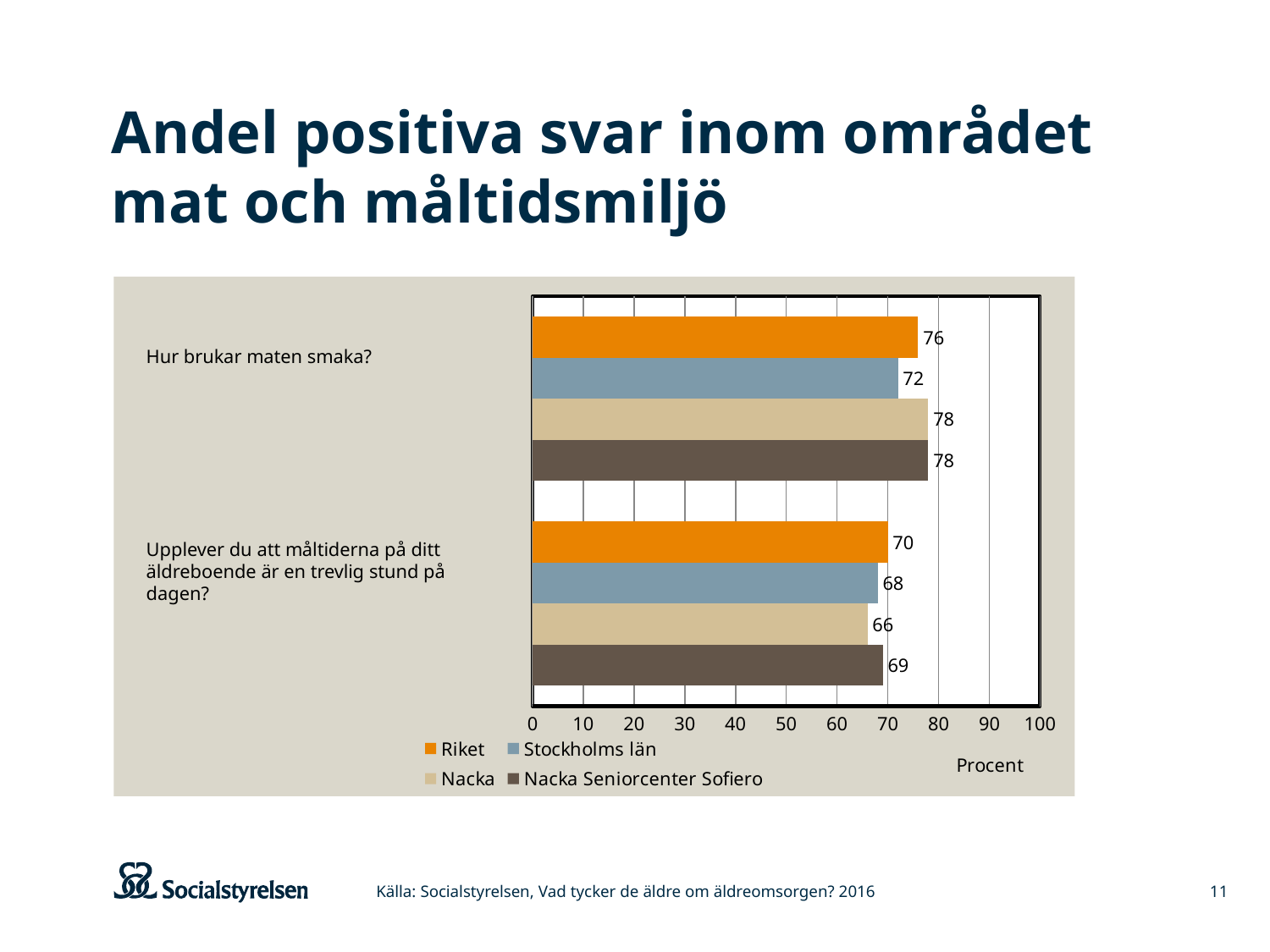
What is the difference between the Riket values for "Hur brukar maten smaka?" and "Upplever du att måltiderna på ditt äldreboende är en trevlig stund på dagen?"? 6 What is the label of the horizontal axis? Procent Which series has the highest value for "Upplever du att måltiderna på ditt äldreboende är en trevlig stund på dagen?"? Riket Which is larger for "Upplever du att måltiderna på ditt äldreboende är en trevlig stund på dagen?": Stockholms län or Nacka? Stockholms län What is the value for Nacka Seniorcenter Sofiero for "Upplever du att måltiderna på ditt äldreboende är en trevlig stund på dagen?"? 69 What is the value for Stockholms län for "Hur brukar maten smaka?"? 72 What is the value for Riket for "Hur brukar maten smaka?"? 76 Which series has the lowest value for "Hur brukar maten smaka?"? Stockholms län What is the value for Nacka for "Upplever du att måltiderna på ditt äldreboende är en trevlig stund på dagen?"? 66 How many series does the legend list? 4 What kind of chart is shown on the slide? Bar chart Is the value for Nacka for "Hur brukar maten smaka?" greater or less than 70? greater